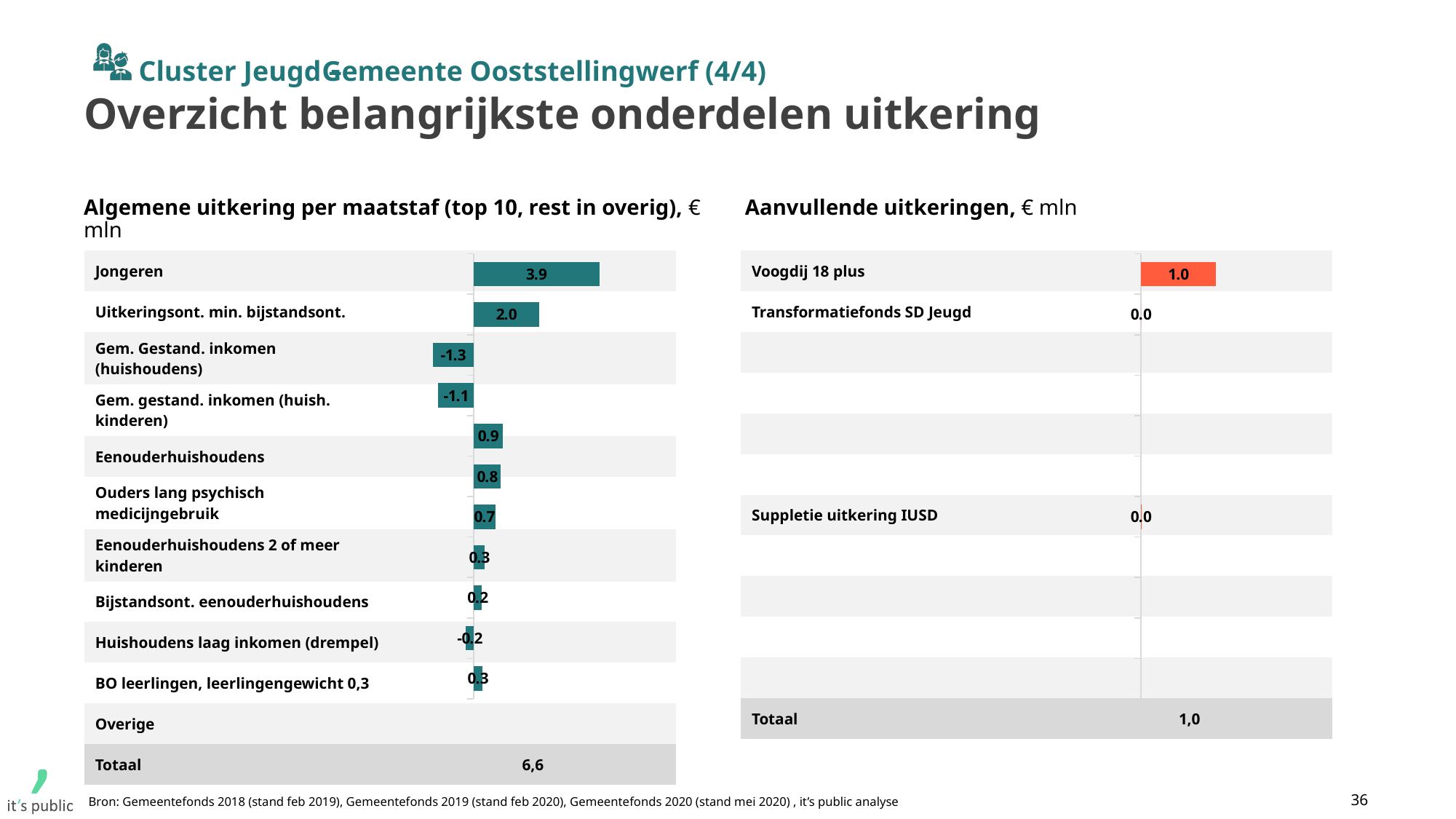
In the chart 'Algemene uitkering per maatstaf', what is the Totaal shown? 6,6 What kind of chart is the 'Aanvullende uitkeringen' chart? Bar chart In the chart 'Algemene uitkering per maatstaf', what is the difference between Jongeren and Uitkeringsont. min. bijstandsont.? 1.9 In the chart 'Algemene uitkering per maatstaf', what is the value for Gem. Gestand. inkomen (huishoudens)? -1.3 In the chart 'Aanvullende uitkeringen', what is the value for Transformatiefonds SD Jeugd? 0.0 In the chart 'Aanvullende uitkeringen', what is the value for Voogdij 18 plus? 1.0 In the chart 'Algemene uitkering per maatstaf', what is the value for Uitkeringsont. min. bijstandsont.? 2.0 In the chart 'Algemene uitkering per maatstaf', which category has the highest value? Jongeren In the chart 'Aanvullende uitkeringen', what is the Totaal shown? 1,0 In the chart 'Algemene uitkering per maatstaf', which category has the lowest value? Gem. Gestand. inkomen (huishoudens) In the chart 'Algemene uitkering per maatstaf', what is the value for Jongeren? 3.9 In the chart 'Algemene uitkering per maatstaf', what is the value for Gem. gestand. inkomen (huish. kinderen)? -1.1